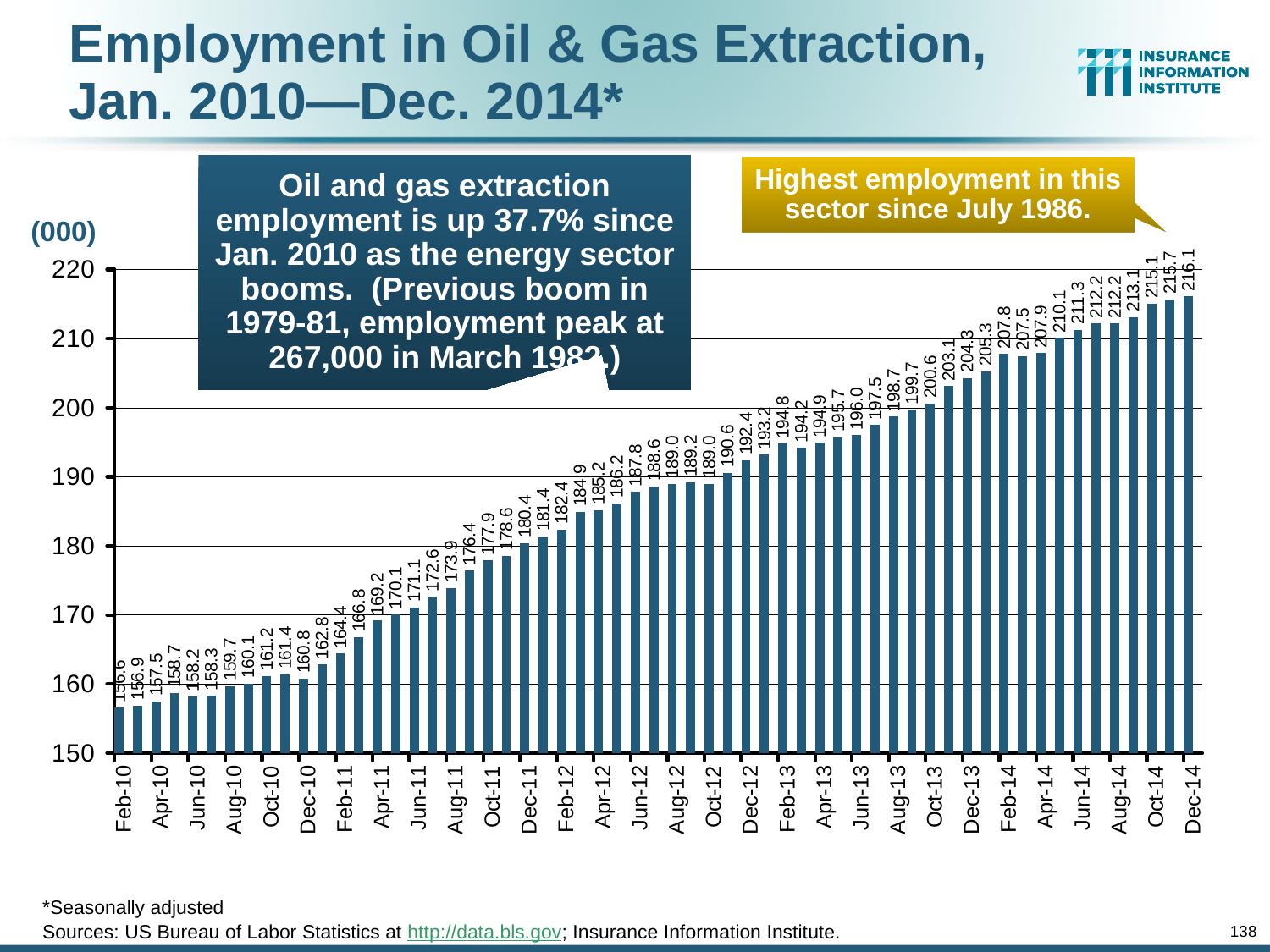
What unit label is shown above the y axis? (000) What is the difference between the Dec-14 value and the Feb-10 value? 59.5 According to the callout, since when is this the highest employment in the sector? July 1986 What is the employment value for Feb-10? 156.6 What kind of chart is shown on the slide? Bar chart Which is larger, the value for Dec-14 or the value for Feb-10? Dec-14 What is the lowest value printed on the chart? 156.6 Is the value for Dec-14 greater or less than 210? greater What is the employment value for Dec-14? 216.1 What is the highest value printed on the chart? 216.1 Which month has the highest employment value on the chart? Dec-14 Do the values generally rise or fall from left to right along the x axis? Rise